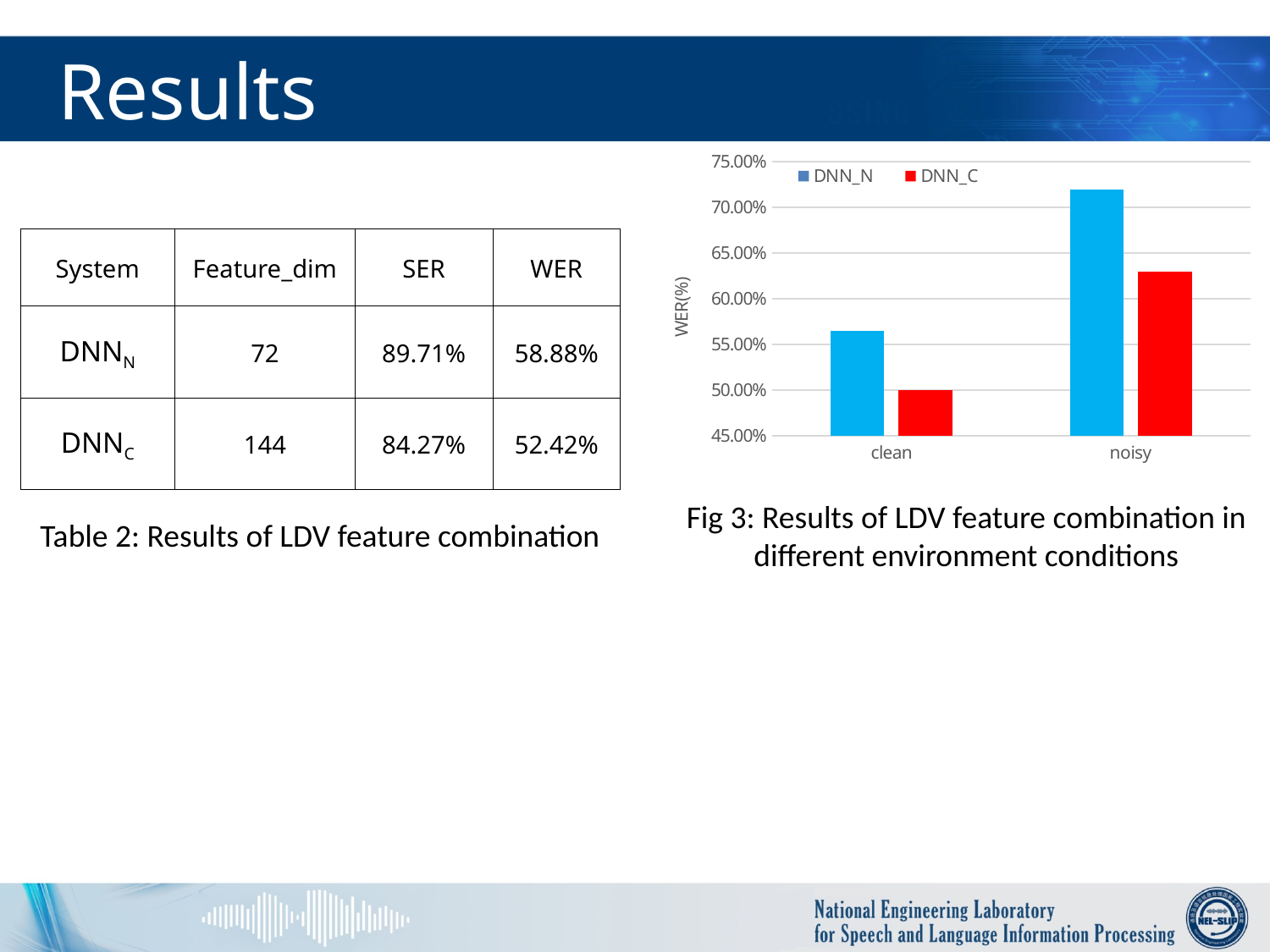
In the Fig 3 chart, which series has the higher WER in the noisy condition, DNN_N or DNN_C? DNN_N In the Fig 3 chart, is the WER for DNN_N in the noisy condition greater or less than 70.00%? greater How many series does the legend of the Fig 3 chart list? 2 In the Fig 3 chart, which bar is the lowest overall? DNN_C in the clean condition Which series are listed in the legend of the Fig 3 chart? DNN_N and DNN_C In the Fig 3 chart, is the WER for DNN_N in the clean condition greater or less than 60.00%? less What is the label of the y axis in the Fig 3 chart? WER(%) In the Fig 3 chart, is the WER for DNN_C in the noisy condition greater or less than 60.00%? greater What kind of chart is shown in Fig 3? bar chart In the Fig 3 chart, which condition has the highest WER for DNN_N? noisy How many environment conditions are shown on the x axis of the Fig 3 chart? 2 In the Fig 3 chart, does the WER for DNN_C rise or fall from the clean to the noisy condition? rise